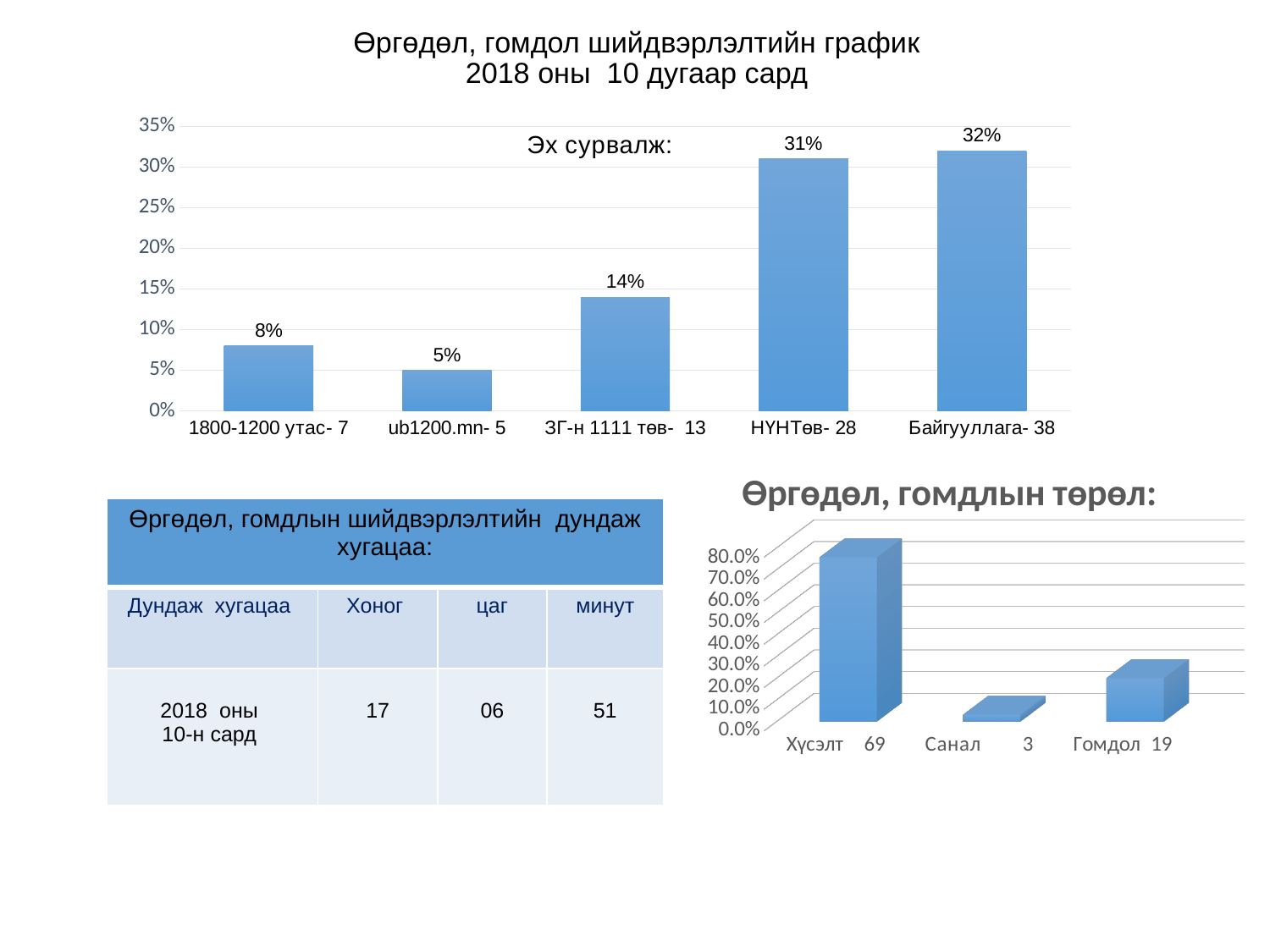
How many categories are shown in the top chart (Эх сурвалж)? 5 In the top chart (Эх сурвалж), what is the value for ub1200.mn- 5? 5% In the top chart (Эх сурвалж), what is the value for НҮНТөв- 28? 31% In the chart titled Өргөдөл, гомдлын төрөл, is the value for Хүсэлт 69 greater or less than 70.0%? greater What kind of chart is the chart titled Өргөдөл, гомдлын төрөл? bar chart In the top chart (Эх сурвалж), what is the difference between the values for Байгууллага- 38 and 1800-1200 утас- 7? 24% In the chart titled Өргөдөл, гомдлын төрөл, which category has the lowest value? Санал 3 In the chart titled Өргөдөл, гомдлын төрөл, is the value for Гомдол 19 greater or less than 30.0%? less In the top chart (Эх сурвалж), which category has the highest value? Байгууллага- 38 In the top chart (Эх сурвалж), what is the value for ЗГ-н 1111 төв- 13? 14% In the top chart (Эх сурвалж), which is larger: the value for 1800-1200 утас- 7 or the value for ЗГ-н 1111 төв- 13? ЗГ-н 1111 төв- 13 In the top chart (Эх сурвалж), which category has the lowest value? ub1200.mn- 5